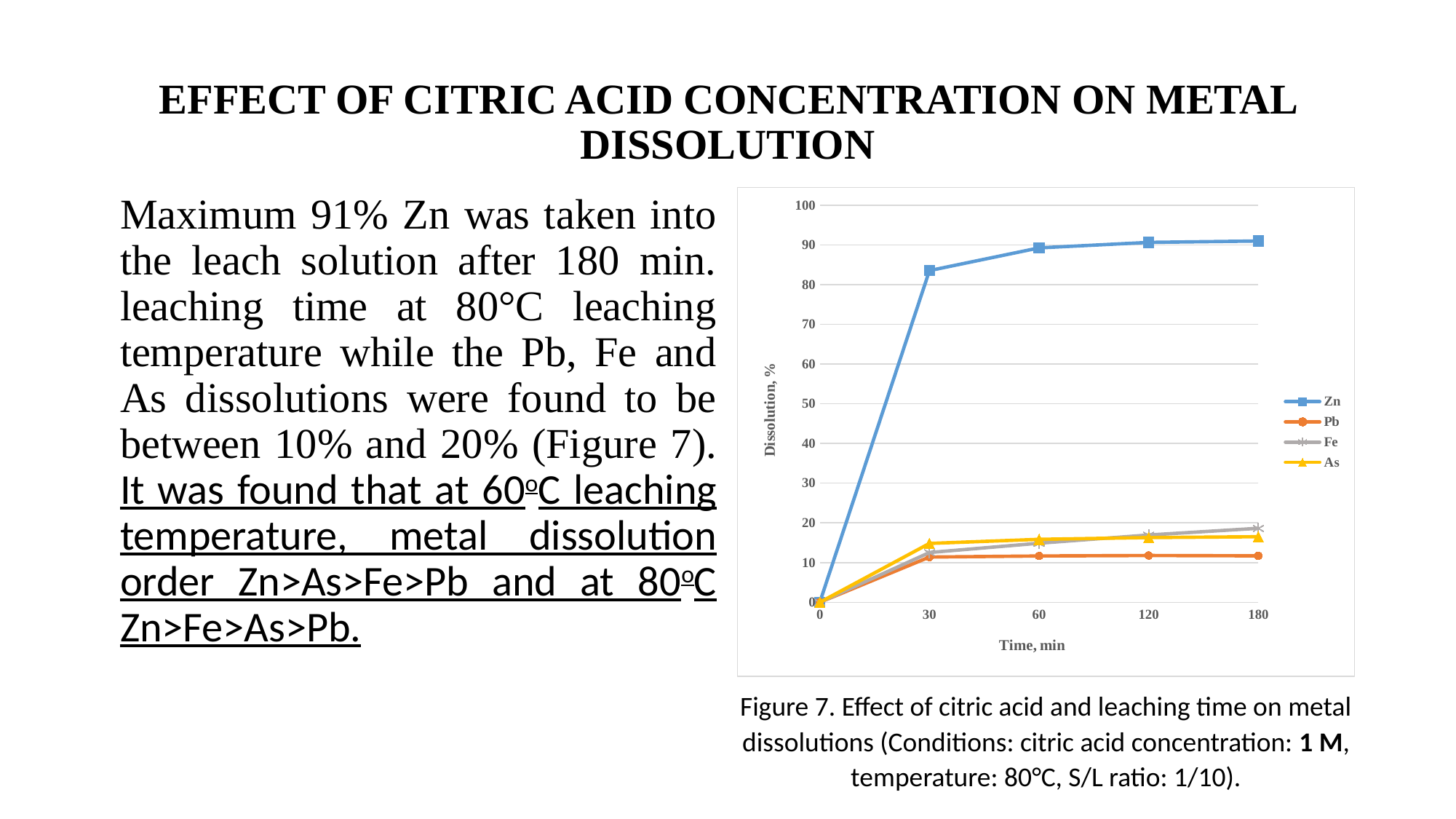
What is the title of the chart's y axis? Dissolution, % Which metal has the lowest dissolution at 180 min? Pb At 60 min, which has the larger dissolution, Zn or Pb? Zn What kind of chart is shown on the slide? line chart How many time points are plotted along the x axis of the chart? 5 Is the dissolution value for Fe at 180 min greater or less than 10? greater Is the dissolution value for Zn at 30 min greater or less than 80? greater How many series does the chart's legend list? 4 Is the dissolution value for Pb at 180 min greater or less than 20? less Does the Zn dissolution rise or fall as time increases from 0 to 180 min? rises Which metal has the highest dissolution at 180 min? Zn At 180 min, which has the larger dissolution, Fe or Pb? Fe